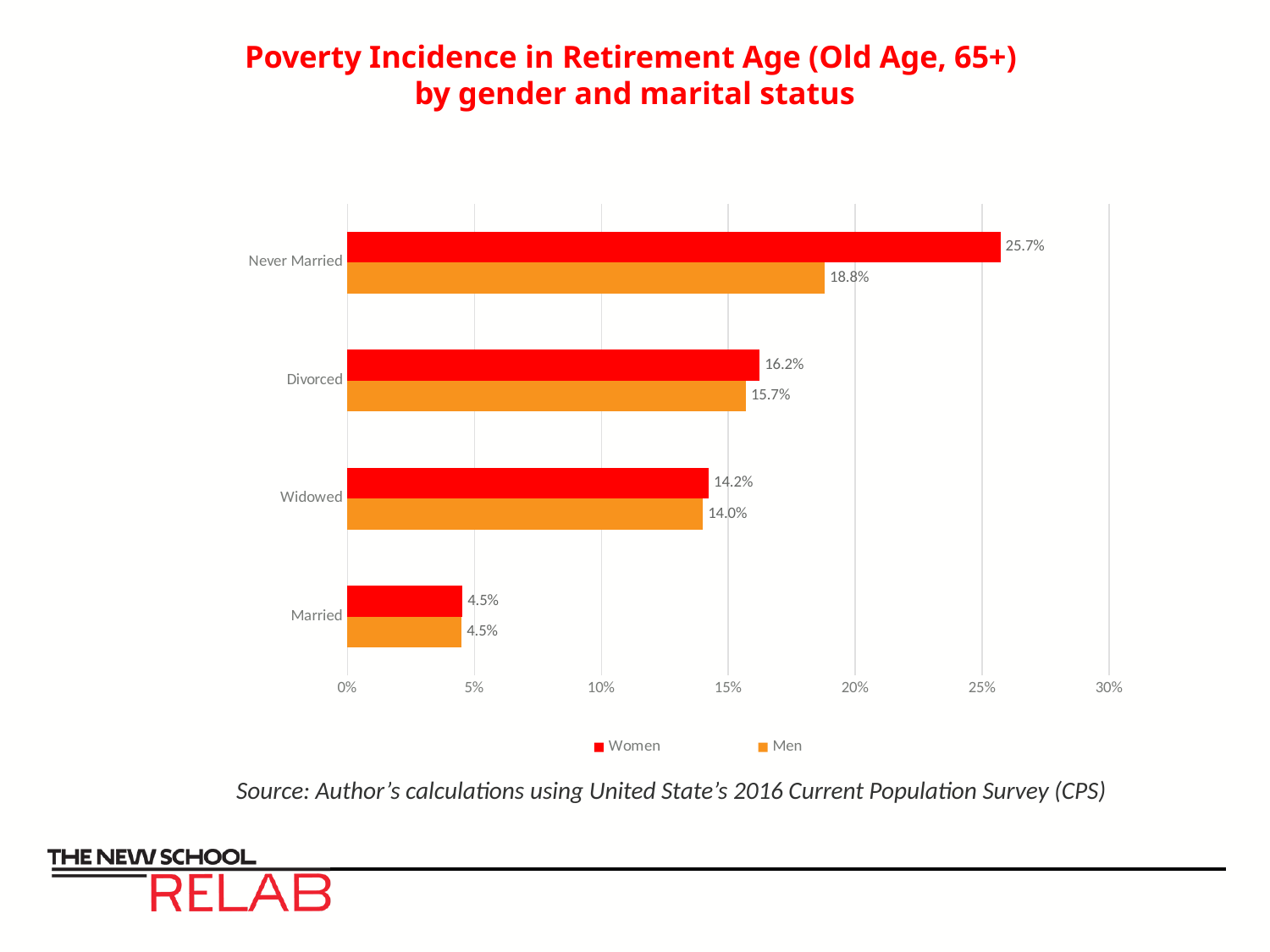
Which marital status has the highest poverty incidence for women? Never Married What is the difference between the poverty incidence of never married women and never married men? 6.9% What is the poverty incidence for never married women? 25.7% What is the difference between the poverty incidence of divorced women and married women? 11.7% Which colour represents Men in the chart? Orange How many series does the legend list? 2 Which is larger, the poverty incidence for never married men or for divorced women? Never married men What is the poverty incidence for divorced men? 15.7% How many marital status categories are shown on the chart? 4 What is the poverty incidence for widowed men? 14.0% What kind of chart is shown on the slide? Bar chart Which marital status has the lowest poverty incidence for men? Married